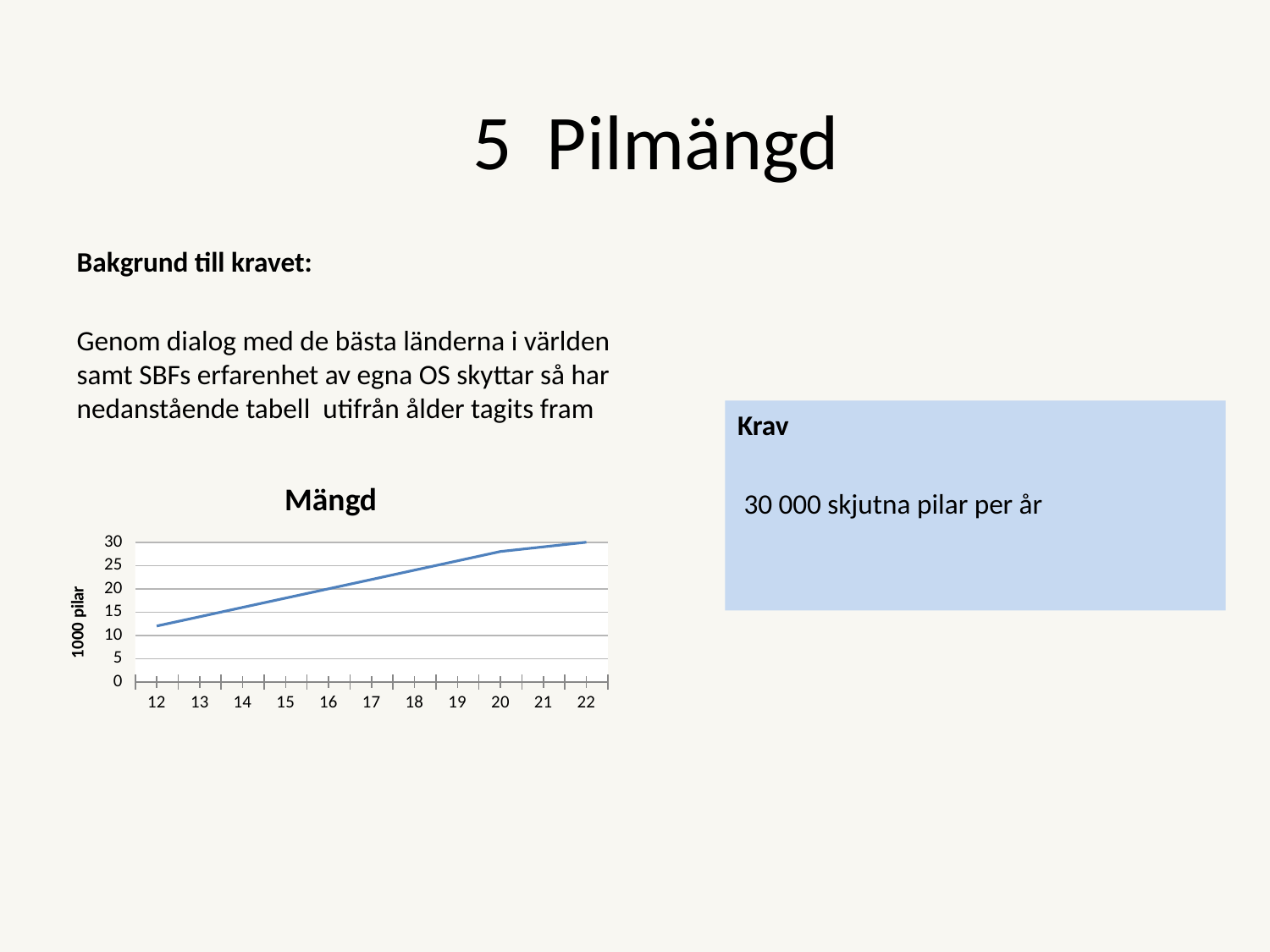
What is the title of the chart on the slide? Mängd Is the value for age 18 in the "Mängd" chart greater or less than 20? greater What is the value for age 22 in the "Mängd" chart? 30 Is the value for age 12 in the "Mängd" chart greater or less than 15? less What is the label on the vertical axis of the "Mängd" chart? 1000 pilar Do the values in the "Mängd" chart rise or fall as age increases from 12 to 22? rise At which age is the value in the "Mängd" chart lowest? 12 At which age is the value in the "Mängd" chart highest? 22 How many age values are shown along the x axis of the "Mängd" chart? 11 What kind of chart is the "Mängd" chart? line chart Is the value for age 20 in the "Mängd" chart greater or less than 25? greater In the "Mängd" chart, which is larger, the value for age 14 or the value for age 19? age 19